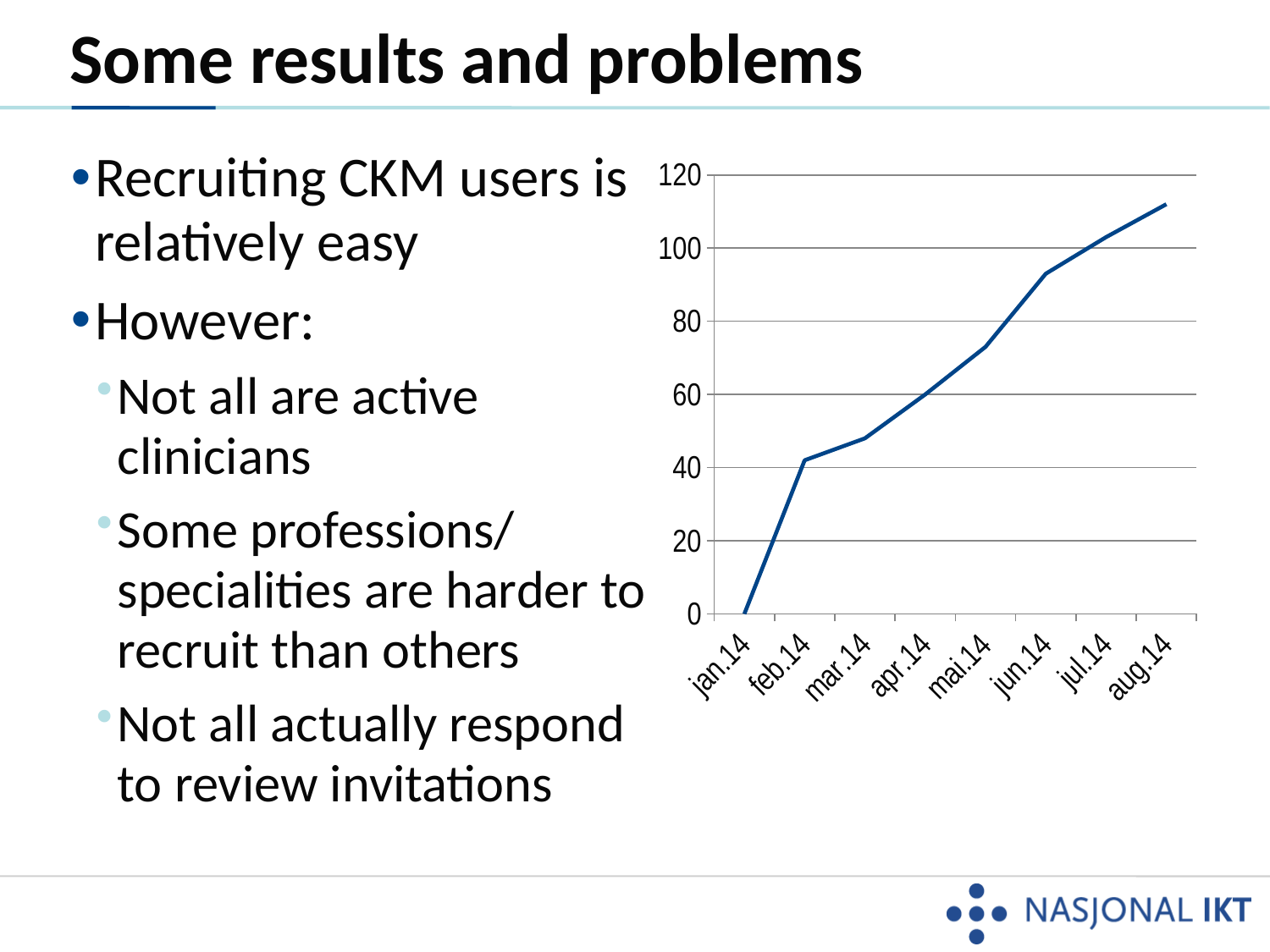
What kind of chart is shown on the slide? line chart Which has the larger value, mar.14 or jun.14? jun.14 Is the value for aug.14 greater or less than 100? greater What is the value for jan.14 in the chart? 0 Which month has the highest value in the chart? aug.14 Is the value for mai.14 greater or less than 60? greater Is the value for feb.14 greater or less than 60? less Which month has the lowest value in the chart? jan.14 How many months are plotted along the x axis of the chart? 8 Do the values in the chart rise or fall from jan.14 to aug.14? rise What colour is the line in the chart? blue